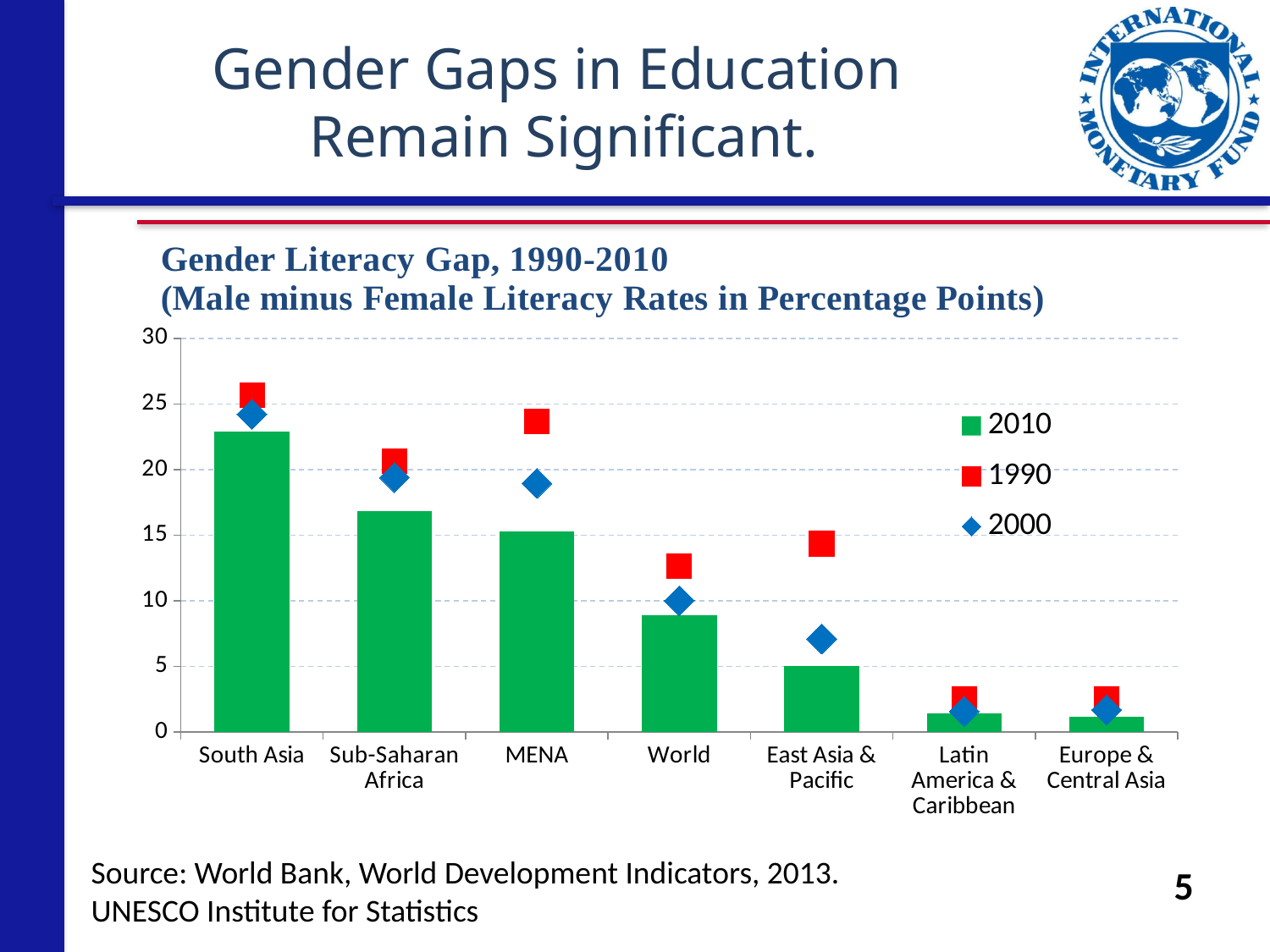
Is the 2000 value for East Asia & Pacific greater or less than 10? less Which region has the highest 2010 gender literacy gap? South Asia How many regions/categories are shown on the x axis? 7 Is the 1990 value for MENA greater or less than 20? greater Do the 2010 bar values rise or fall moving from left to right across the regions? fall Is the 2010 value for South Asia greater or less than 20? greater What kind of chart is shown on the slide? bar chart How many series does the legend list? 3 Which is larger, the 1990 value for South Asia or the 1990 value for World? South Asia Which year is represented by the green bars according to the legend? 2010